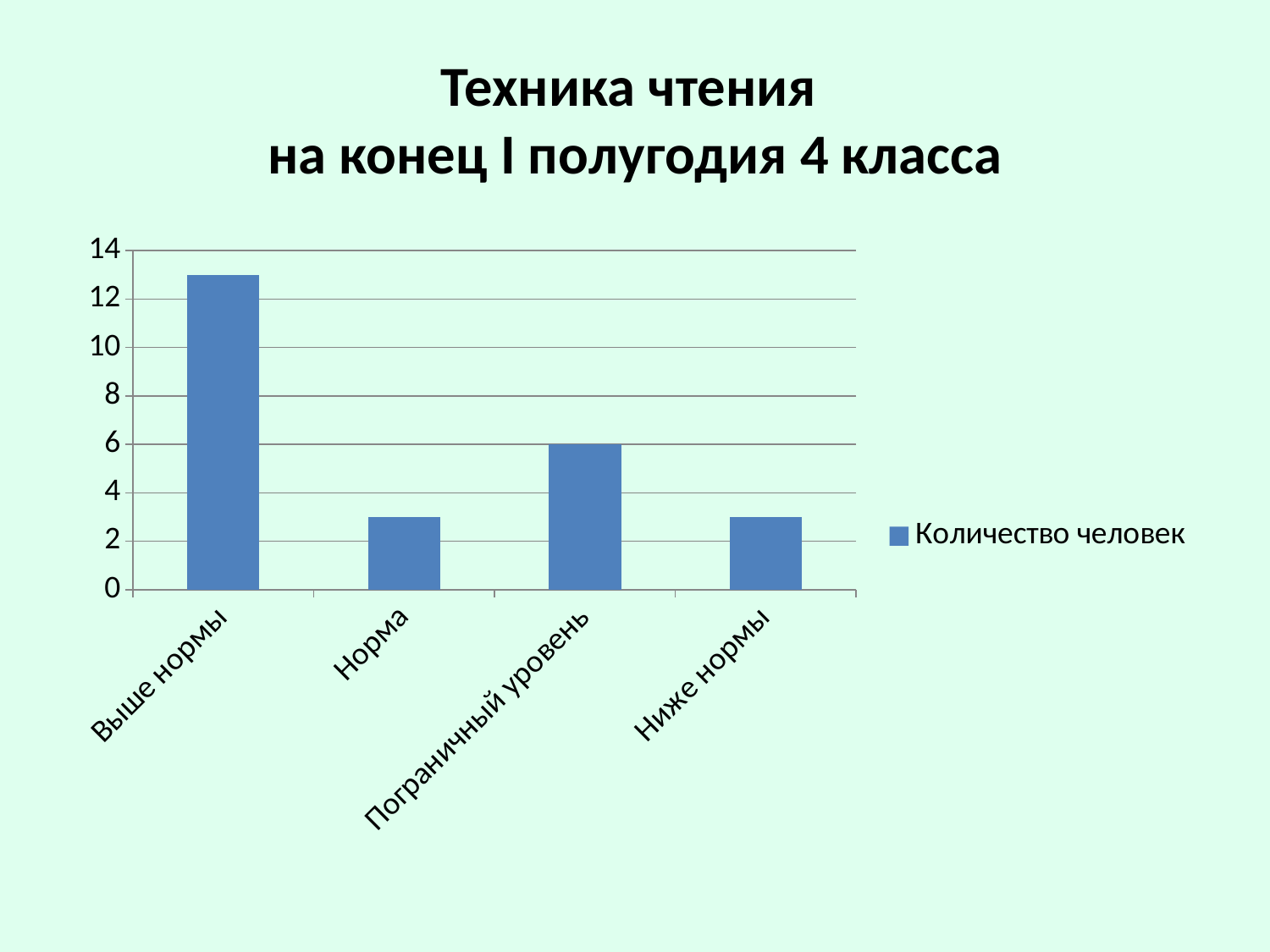
How many series does the legend list? 1 Which category has the highest value? Выше нормы What is the title of the slide? Техника чтения на конец I полугодия 4 класса What is the value for Пограничный уровень? 6 Which is larger, the value for Пограничный уровень or the value for Норма? Пограничный уровень How many categories are shown on the x axis of the chart? 4 Is the value for Выше нормы greater or less than 12? greater Is the value for Норма greater or less than 4? less Is the value for Ниже нормы greater or less than 2? greater Which is larger, the value for Выше нормы or the value for Пограничный уровень? Выше нормы What kind of chart is shown on the slide? bar chart What series name is shown in the legend? Количество человек